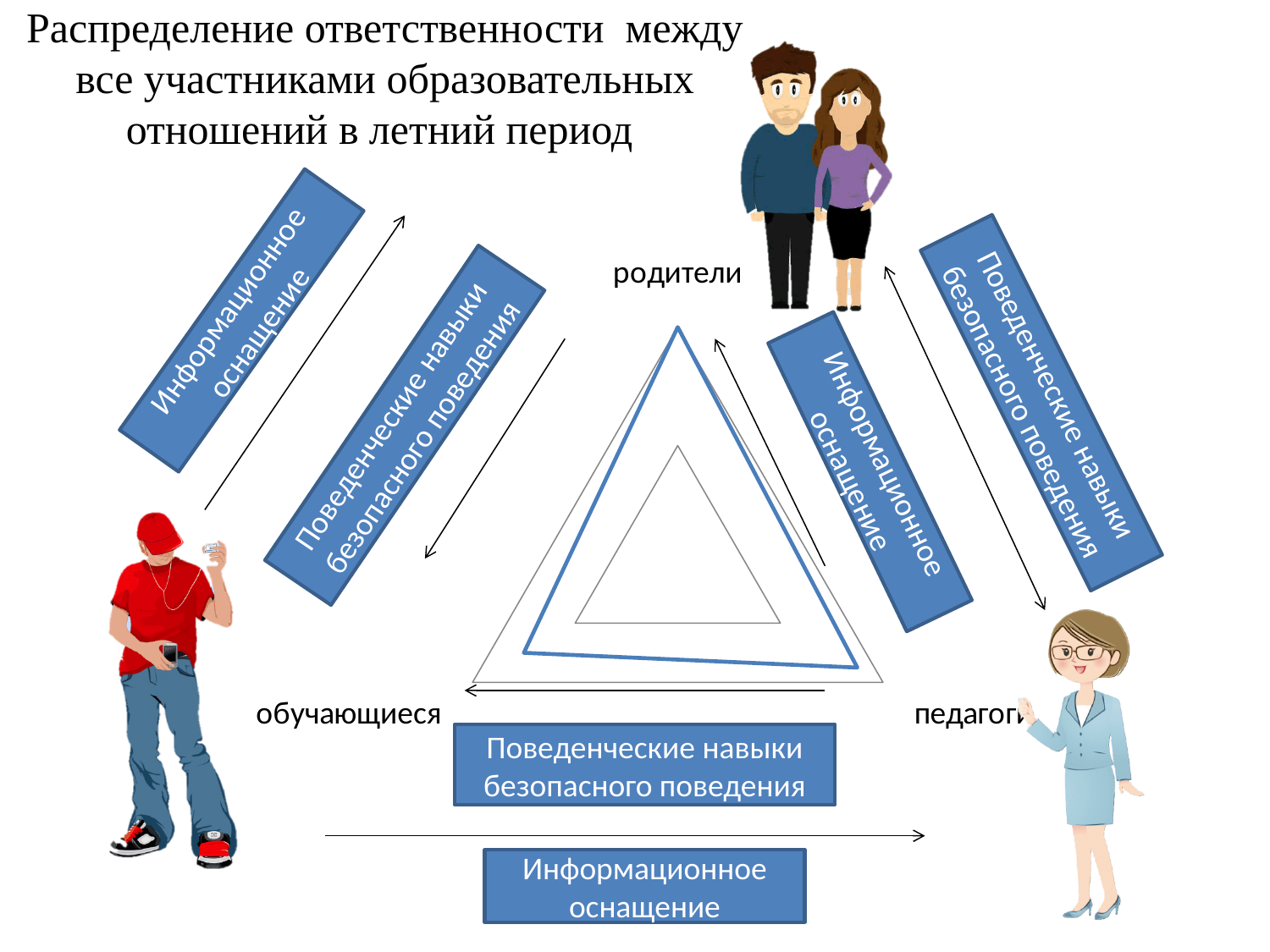
Which category label appears at the top vertex of the radar chart? родители What kind of chart is shown in the centre of the slide? Radar chart How many categories (axes) does the radar chart have? 3 Which category label appears at the bottom-left vertex of the radar chart? обучающиеся What colour is the plotted data line on the radar chart? Blue Which category label appears at the bottom-right vertex of the radar chart? педагоги